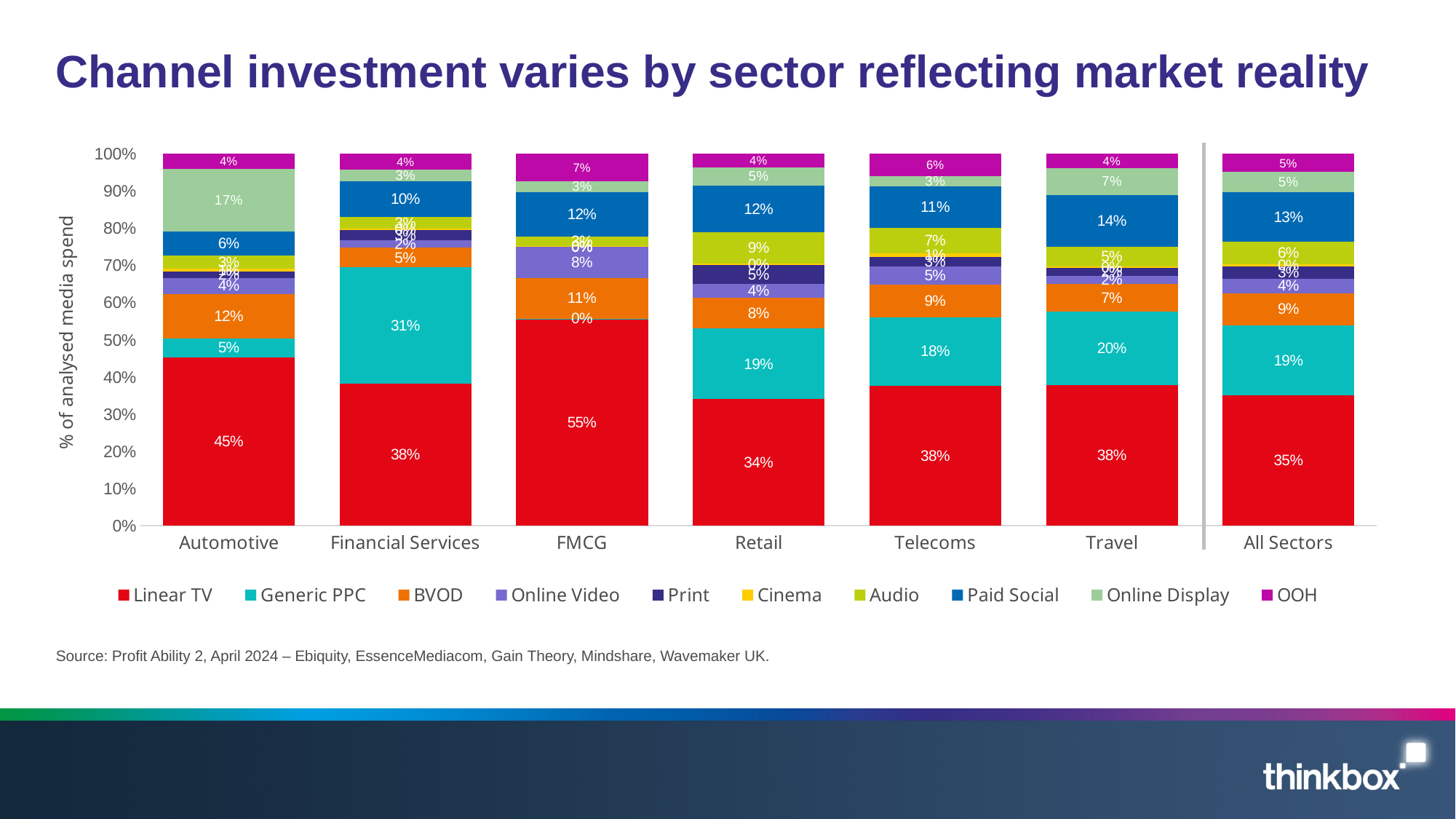
What is the Generic PPC share for Financial Services? 31% Which sector has the highest Linear TV share? FMCG What is the Linear TV share of analysed media spend for FMCG? 55% What kind of chart is shown on the slide? Stacked bar chart Which is larger: the BVOD share for Automotive or the BVOD share for Telecoms? Automotive Which sector has the lowest Linear TV share? Retail What is the difference between the Linear TV share for FMCG and for Retail? 21 percentage points How many series does the legend list? 10 What is the Online Display share for Automotive? 17% What is the label on the vertical axis? % of analysed media spend How many sectors are shown on the x axis? 7 What is the Paid Social share for Travel? 14%